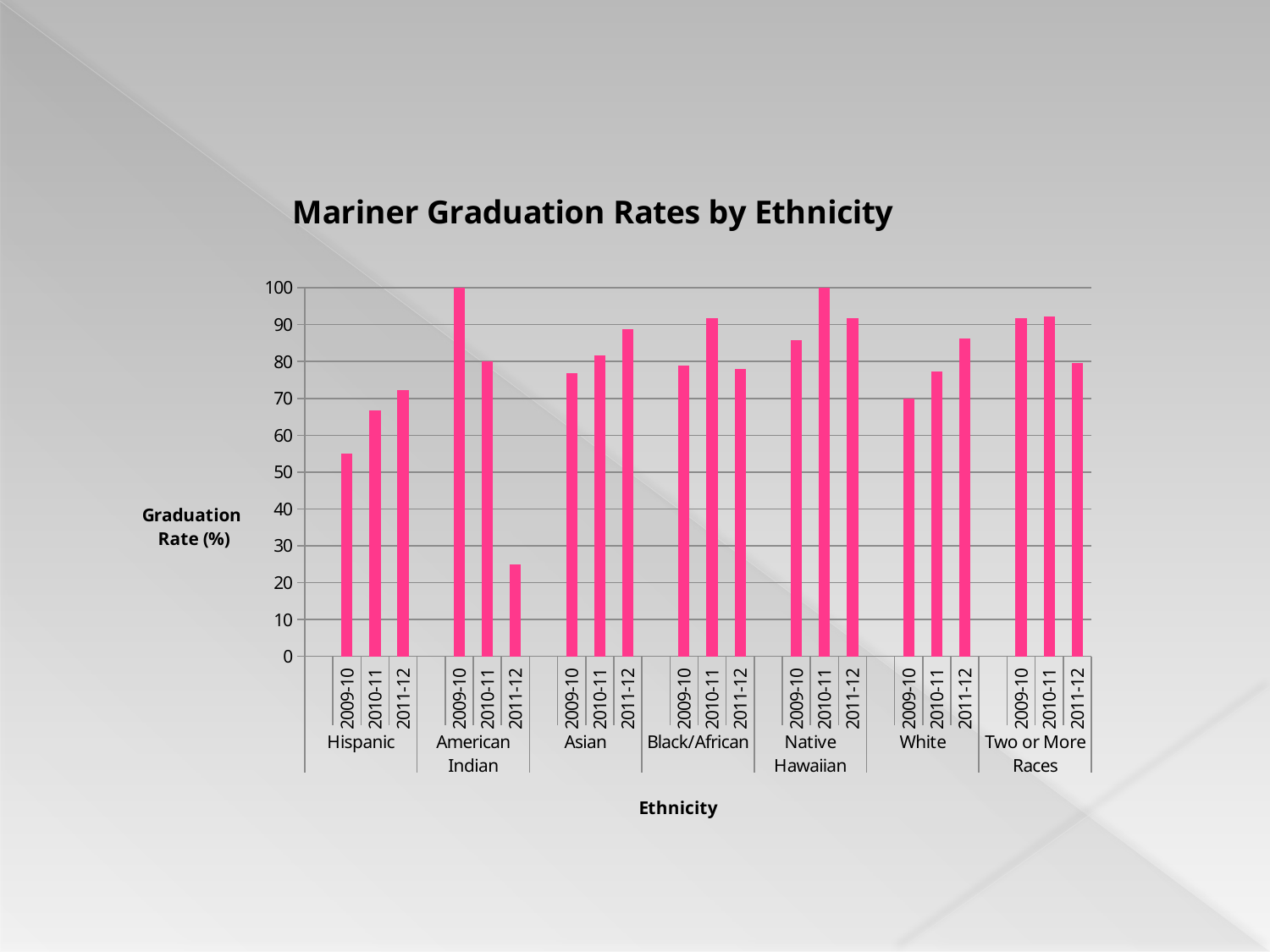
Do the graduation rates for Hispanic students rise or fall from 2009-10 to 2011-12? rise Is the graduation rate for American Indian students in 2011-12 greater or less than 30? less What is the graduation rate for American Indian students in 2009-10? 100 Which bar shows the lowest graduation rate on the chart? American Indian 2011-12 How many ethnicity groups are shown on the x axis? 7 Is the graduation rate for Hispanic students in 2009-10 greater or less than 60? less Which is larger, the 2009-10 graduation rate for Hispanic students or for Asian students? Asian What is the label on the vertical axis of the chart? Graduation Rate (%) What is the graduation rate for Native Hawaiian students in 2010-11? 100 What type of chart is shown on the slide? bar chart What is the title of the chart? Mariner Graduation Rates by Ethnicity Is the graduation rate for Black/African students in 2010-11 greater or less than 90? greater